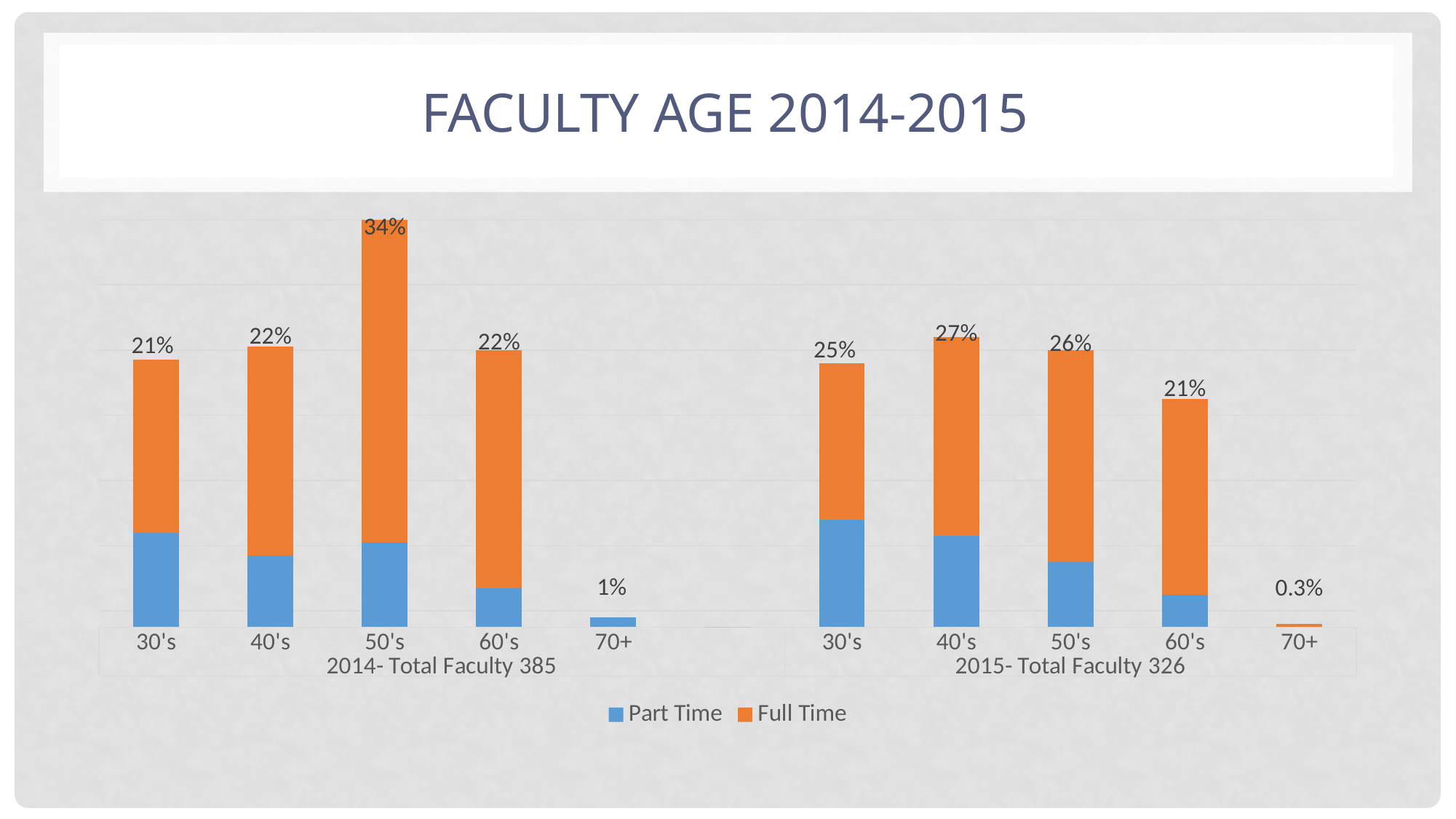
Which age group has the lowest labelled percentage in 2015? 70+ What is the difference in percentage points between the 50's and 30's age groups in 2014? 13 percentage points Which age group has the highest labelled percentage in 2014? 50's What kind of chart is shown on the slide? Stacked bar chart What is the labelled percentage for the 50's age group in 2014? 34% Which has the larger labelled percentage in 2015, the 40's or the 50's age group? 40's What is the labelled percentage for the 30's age group in 2015? 25% What was the total faculty in 2015 according to the axis label? 326 Which year has the larger labelled percentage for the 60's age group, 2014 or 2015? 2014 How many age groups are shown for each year? 5 How many series does the legend list? 2 What is the labelled percentage for the 70+ age group in 2015? 0.3%